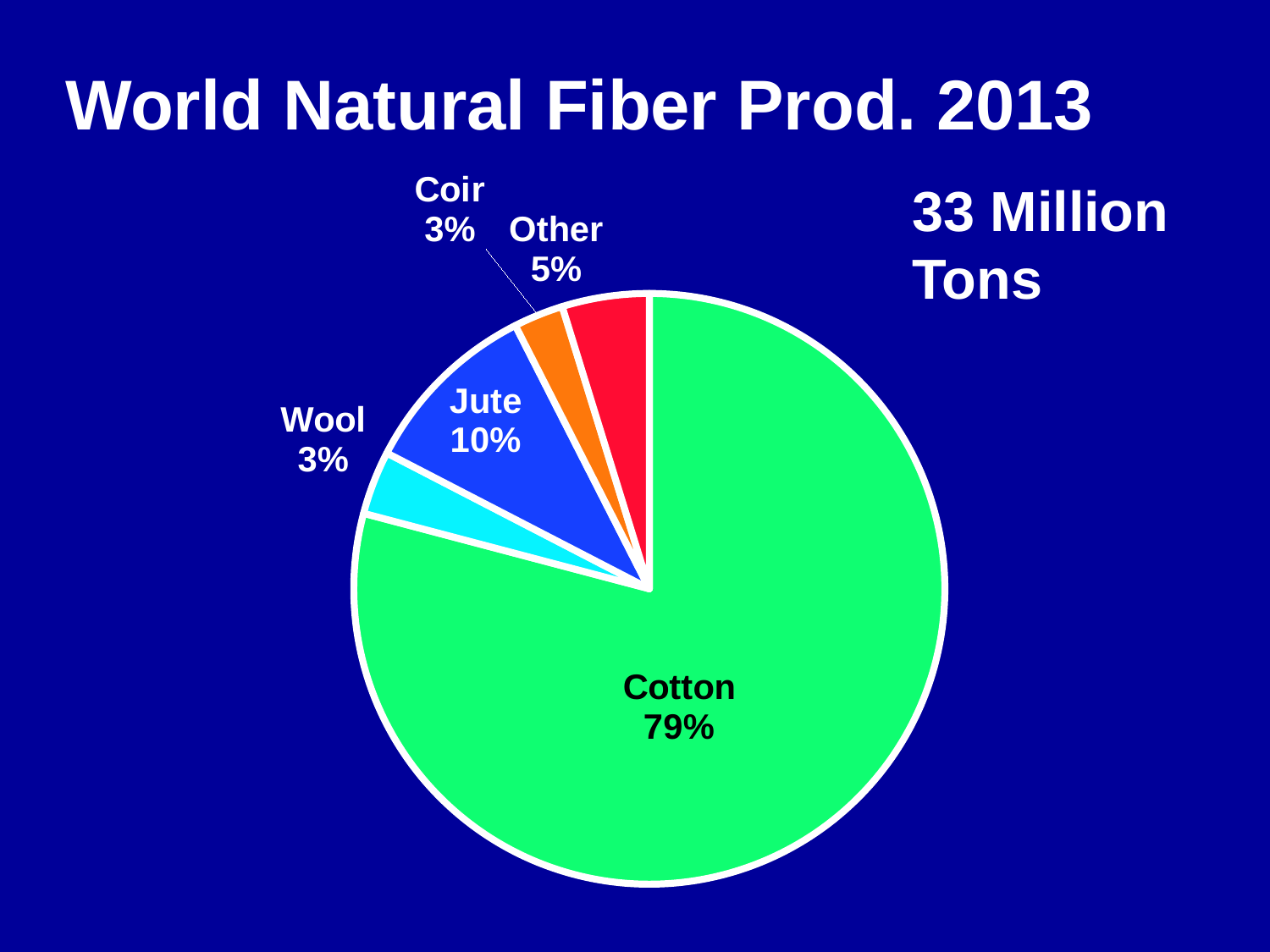
Which fiber has the largest share of the pie? Cotton What total production figure is shown next to the pie chart? 33 Million Tons How many slices does the pie chart have? 5 What is the difference in percentage points between Cotton and Jute? 69 What type of chart is shown on the slide? pie chart What share of the pie does Jute represent? 10% Which is larger, the share for Jute or the share for Other? Jute What percentage is shown for Coir? 3% What share of world natural fiber production does Cotton account for? 79% What percentage is shown for Wool? 3% What percentage is shown for the Other slice? 5% What is the title of the slide? World Natural Fiber Prod. 2013